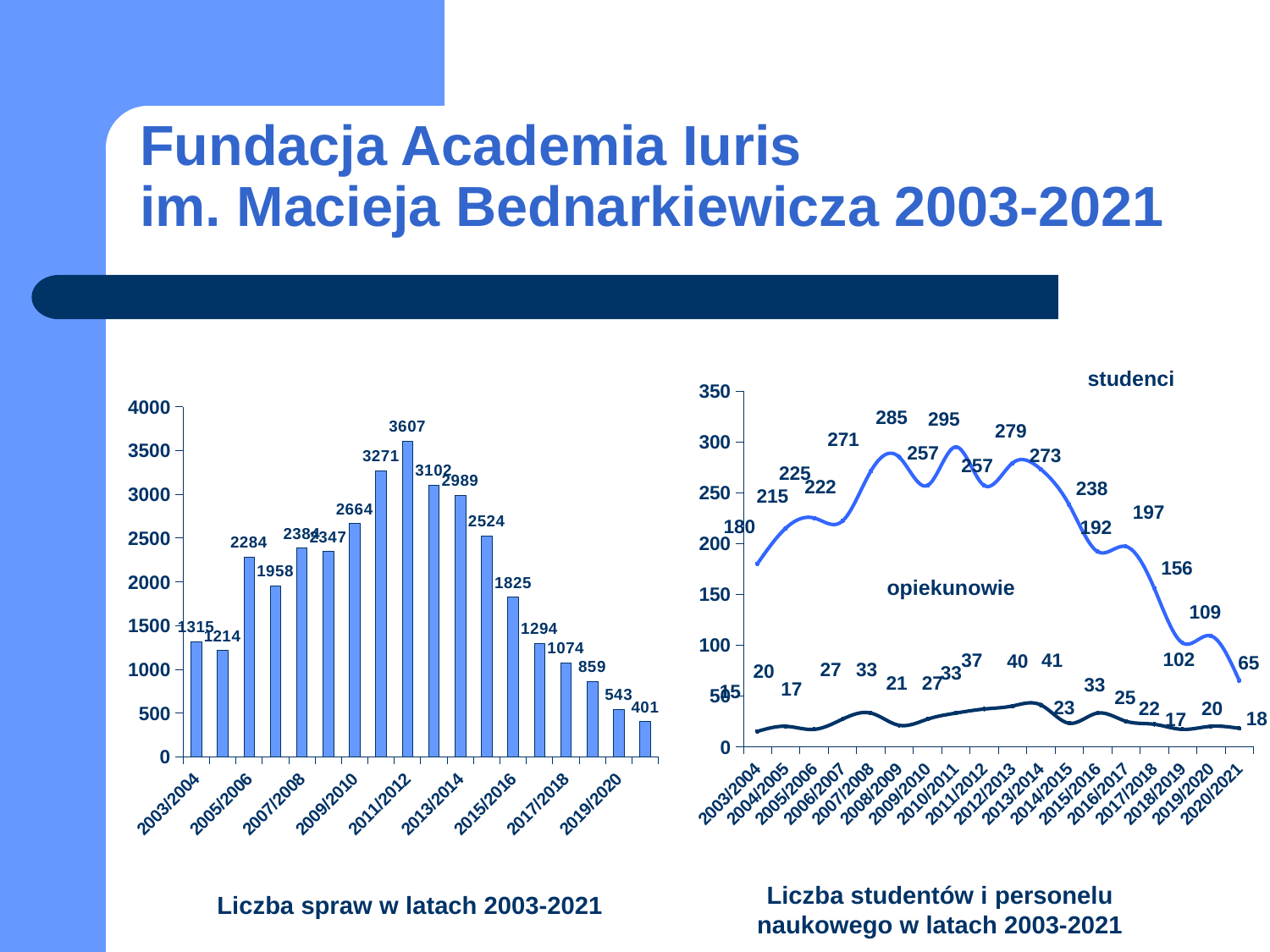
In the chart 'Liczba spraw w latach 2003-2021', what is the difference between the values for 2011/2012 and 2019/2020? 3064 In the chart 'Liczba spraw w latach 2003-2021', what is the lowest value shown? 401 In the chart 'Liczba studentów i personelu naukowego w latach 2003-2021', in which year does the studenci series reach its highest value? 2010/2011 How many bars are plotted in the chart 'Liczba spraw w latach 2003-2021'? 18 What kind of chart is 'Liczba studentów i personelu naukowego w latach 2003-2021'? Line chart In the chart 'Liczba studentów i personelu naukowego w latach 2003-2021', does the studenci series rise or fall from 2013/2014 to 2020/2021? Fall How many series are plotted in the chart 'Liczba studentów i personelu naukowego w latach 2003-2021'? 2 In the chart 'Liczba spraw w latach 2003-2021', which year has the highest number of cases? 2011/2012 What kind of chart is 'Liczba spraw w latach 2003-2021'? Bar chart In the chart 'Liczba spraw w latach 2003-2021', what is the value for 2013/2014? 2989 In the chart 'Liczba studentów i personelu naukowego w latach 2003-2021', what is the value for opiekunowie in 2013/2014? 41 In the chart 'Liczba studentów i personelu naukowego w latach 2003-2021', what is the value for studenci in 2020/2021? 65